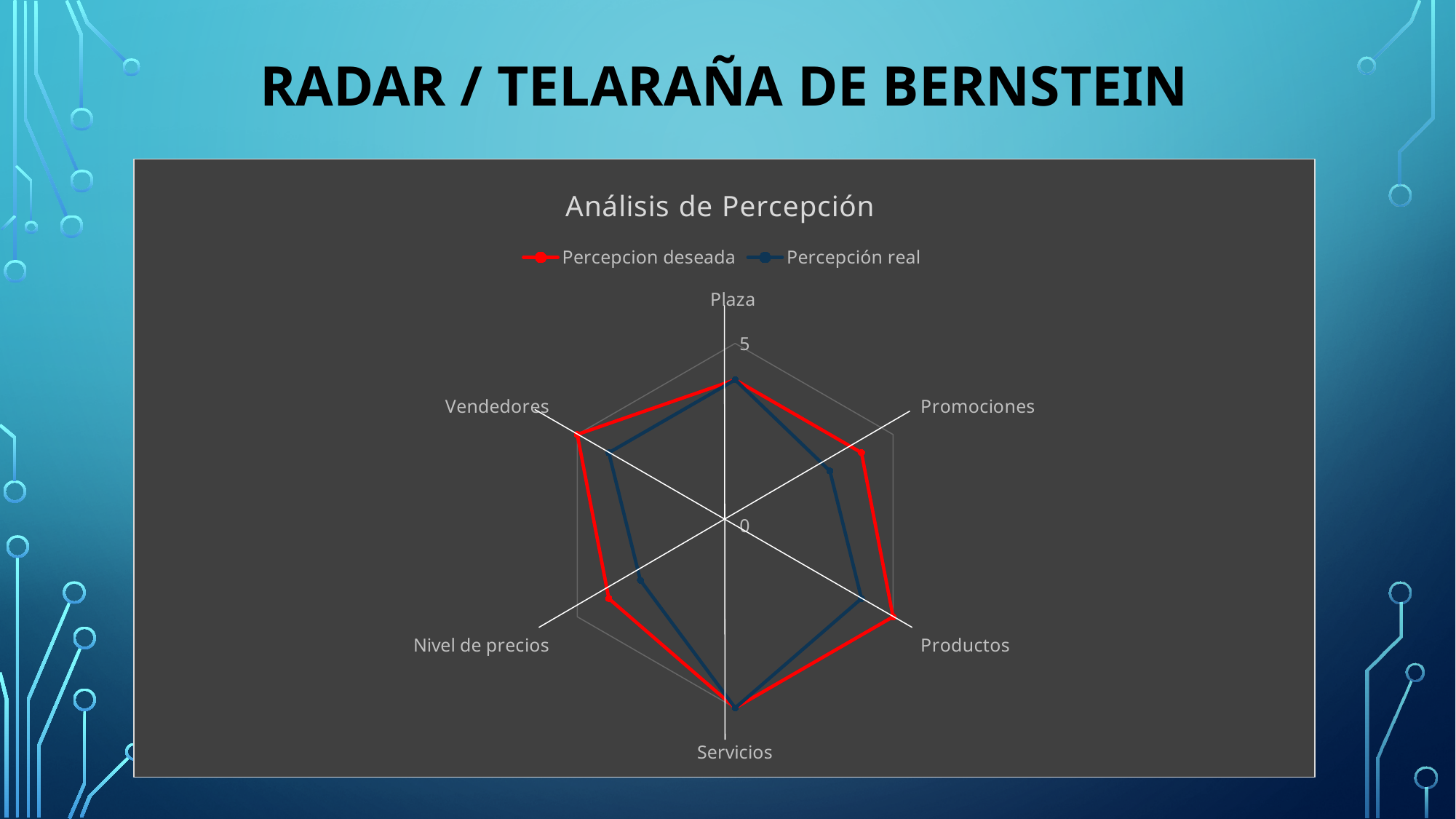
How many series does the legend list? 2 For Nivel de precios, which series has the larger value, 'Percepcion deseada' or 'Percepción real'? Percepcion deseada What is the title of the chart? Análisis de Percepción Is the 'Percepción real' value for Promociones greater or less than 5? less Which category has the highest 'Percepción real' value? Servicios What is the 'Percepcion deseada' value for Servicios? 5 What is the 'Percepcion deseada' value for Productos? 5 What type of chart is shown on the slide? Radar chart Which colour represents the 'Percepcion deseada' series? Red Is the 'Percepción real' value for Productos greater or less than 5? less How many categories (axes) does the radar chart have? 6 For Promociones, which series has the larger value, 'Percepcion deseada' or 'Percepción real'? Percepcion deseada